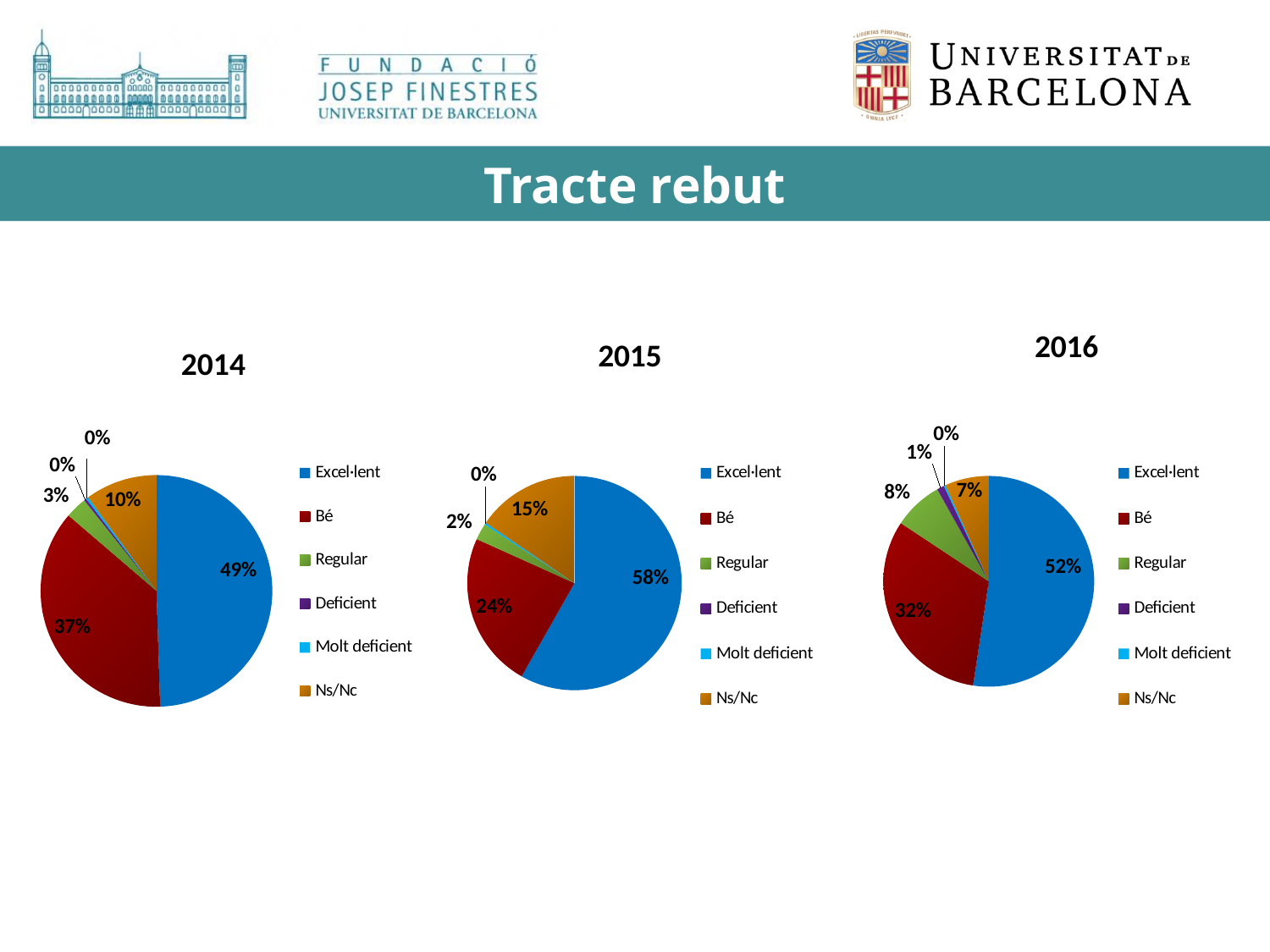
In the 2015 chart, what is the value for Bé? 24% In the 2014 chart, what is the value for Ns/Nc? 10% In the 2014 chart, what share of the pie is Excel·lent? 49% What type of chart is used for the 2014 data? Pie chart How many categories does the legend of the 2016 chart list? 6 In the 2015 chart, which category has the largest slice? Excel·lent In the 2015 chart, what is the difference between Excel·lent and Ns/Nc? 43% What is the title of the slide containing the three pie charts? Tracte rebut In the 2016 chart, what is the difference between Excel·lent and Bé? 20% In the 2014 chart, what is the value for Bé? 37% In the 2016 chart, what is the value for Regular? 8% In the 2016 chart, which is larger, Bé or Ns/Nc? Bé